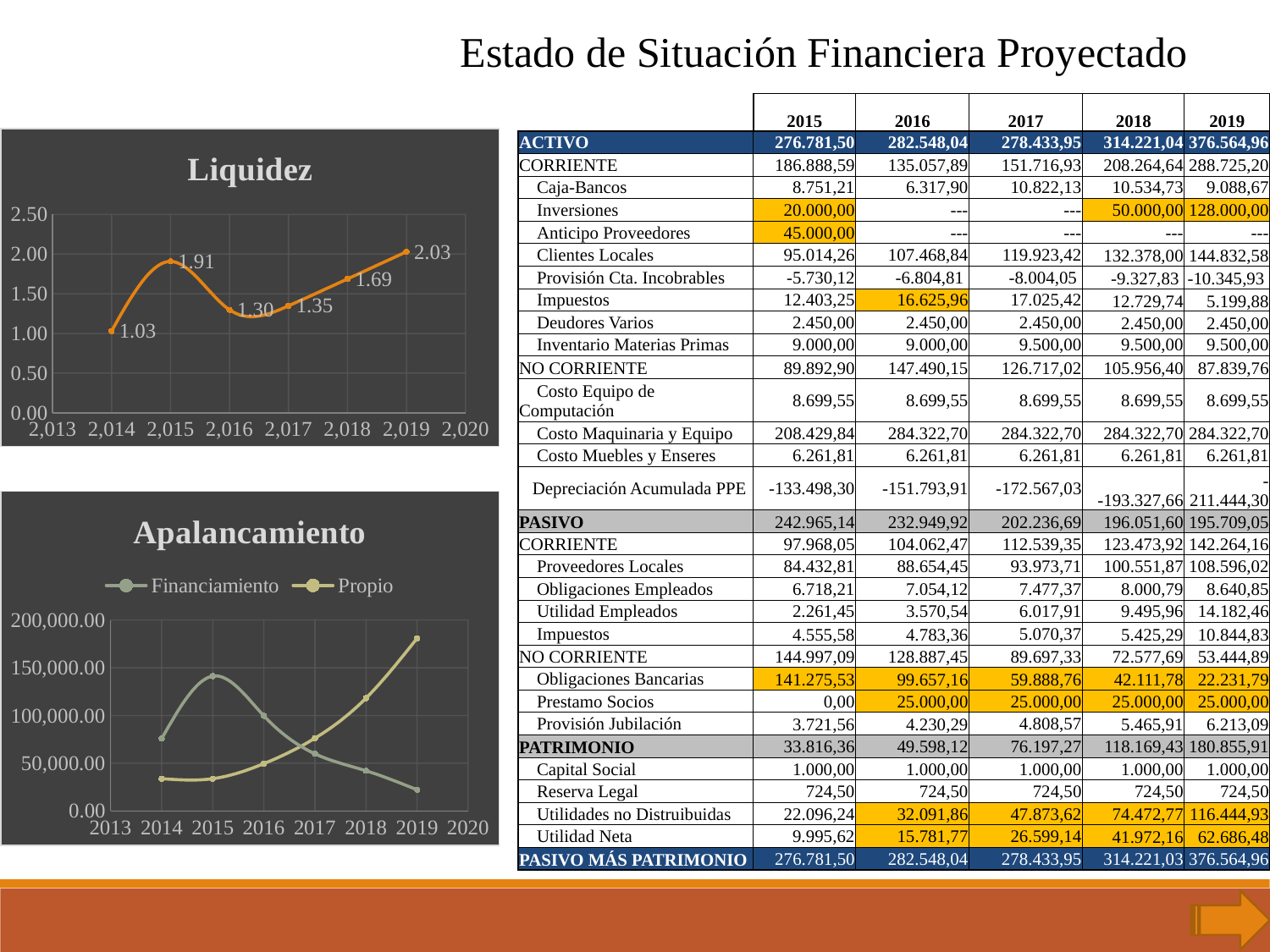
In the Liquidez chart, what is the value for 2015? 1.91 In the Liquidez chart, which year has the lowest value? 2014 What kind of chart is the Liquidez chart? Line chart In the Apalancamiento chart, what are the two series named in the legend? Financiamiento and Propio In the Liquidez chart, which year has the larger value, 2016 or 2017? 2017 In the Liquidez chart, what is the difference between the values for 2019 and 2014? 1.00 In the Liquidez chart, what is the value for 2019? 2.03 In the Apalancamiento chart, is the value for Financiamiento in 2015 greater or less than 100,000.00? greater In the Liquidez chart, how many data points are plotted? 6 In the Liquidez chart, which year has the highest value? 2019 In the Apalancamiento chart, how many series does the legend list? 2 In the Apalancamiento chart, is the value for Propio in 2019 greater or less than 150,000.00? greater